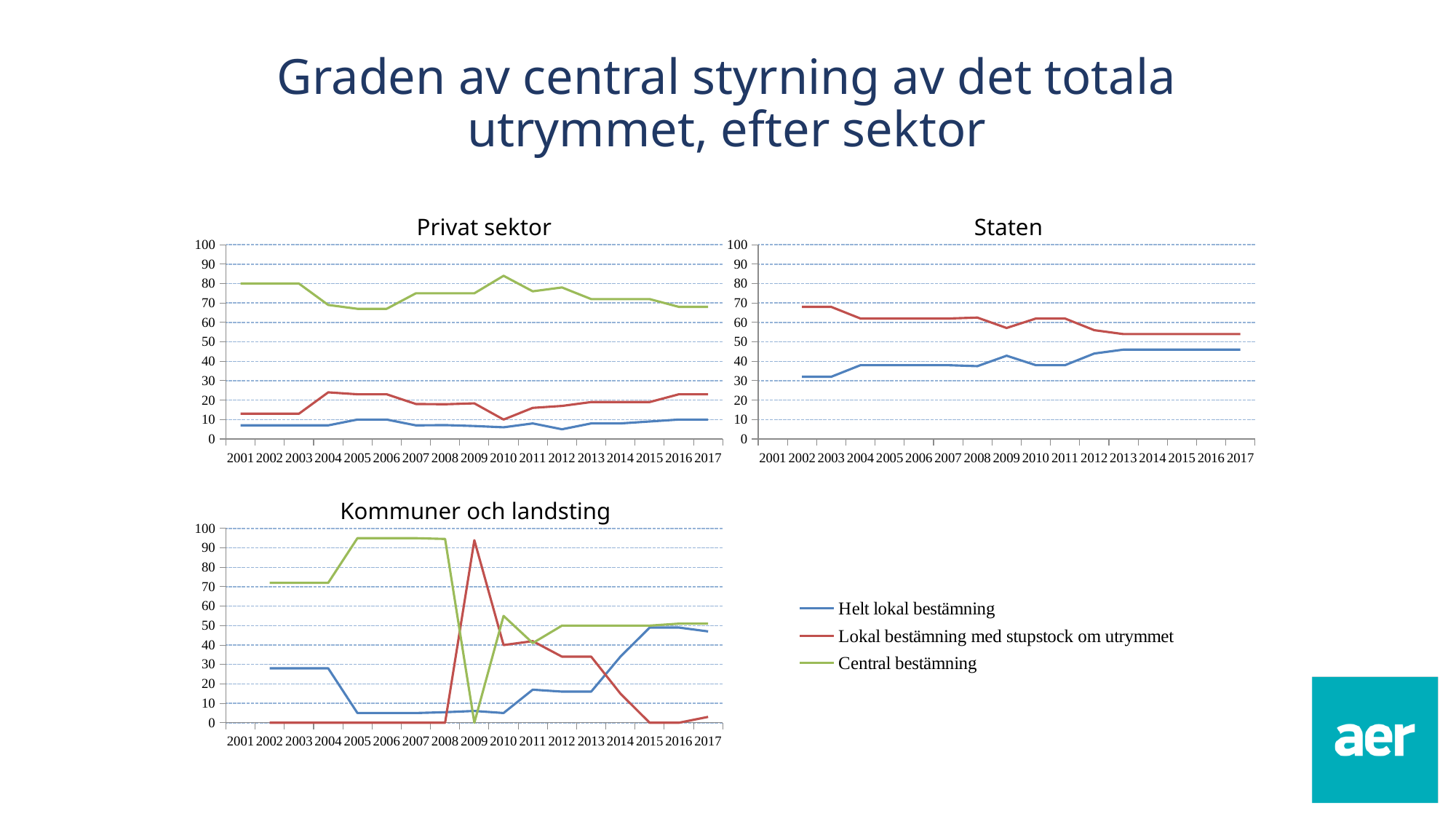
How many series does the legend on the slide list? 3 What is the title of the chart at the bottom left of the slide? Kommuner och landsting In the 'Privat sektor' chart, is the value for Central bestämning in 2010 greater or less than 80? greater In the 'Staten' chart, is the value for Helt lokal bestämning in 2002 greater or less than 40? less What kind of chart is the 'Privat sektor' chart? line chart In the 'Kommuner och landsting' chart, is the value for Lokal bestämning med stupstock om utrymmet in 2009 greater or less than 80? greater In the 'Privat sektor' chart, which series has the highest value in 2010? Central bestämning In the 'Kommuner och landsting' chart, in which year does Central bestämning reach its lowest value? 2009 In the 'Staten' chart, which series is larger in 2017: Helt lokal bestämning or Lokal bestämning med stupstock om utrymmet? Lokal bestämning med stupstock om utrymmet In the 'Staten' chart, does the Helt lokal bestämning line rise or fall from 2002 to 2017? rise In the 'Privat sektor' chart, how many years are shown on the x axis? 17